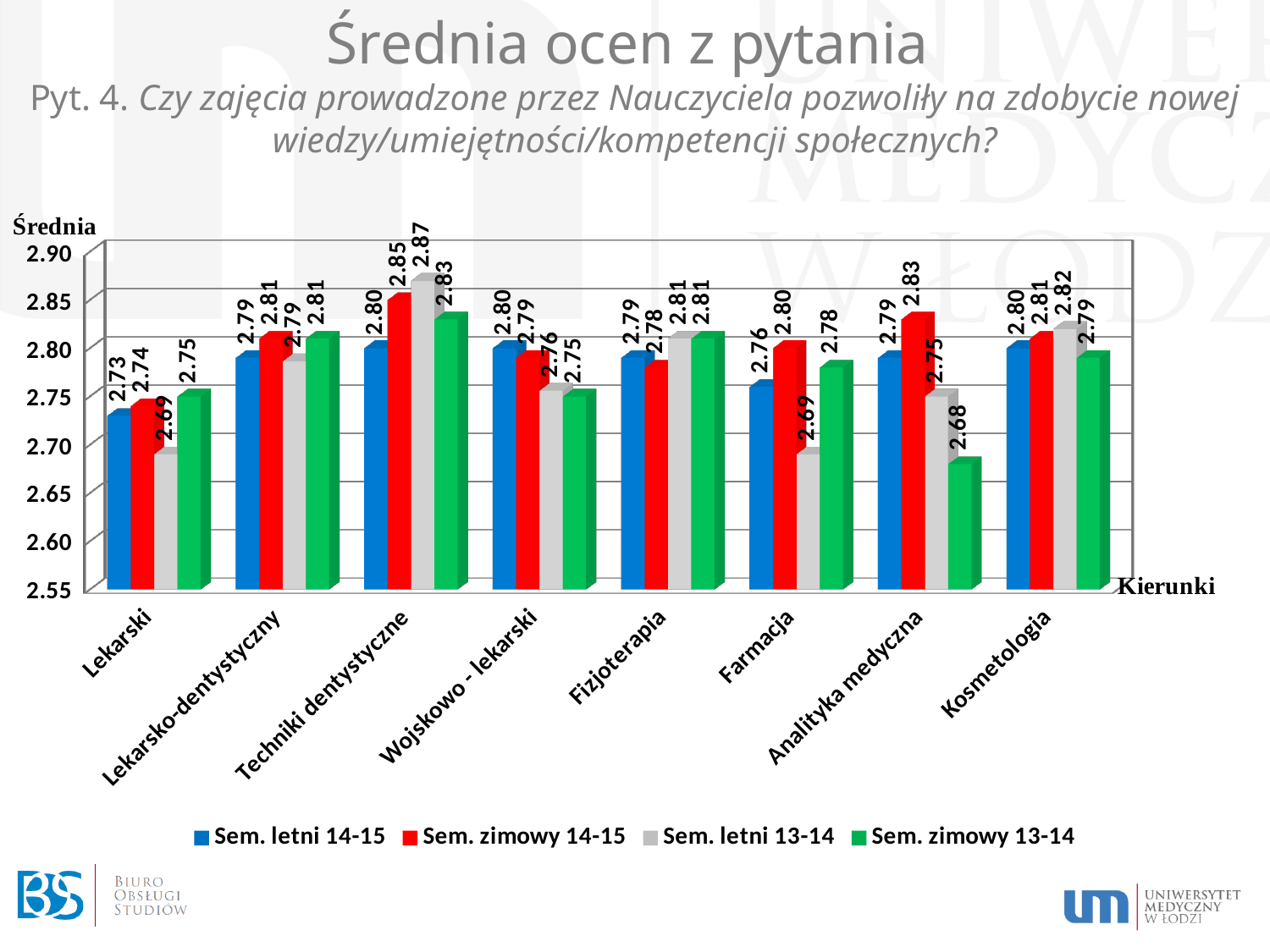
What is the value for Lekarski in the Sem. letni 14-15 series? 2.73 What is the value for Farmacja in the Sem. zimowy 14-15 series? 2.80 How many categories (kierunki) are shown on the x axis? 8 Which category has the lowest value in the Sem. letni 14-15 series? Lekarski Which colour represents the Sem. letni 13-14 series in the legend? Grey What is the value for Techniki dentystyczne in the Sem. letni 13-14 series? 2.87 What kind of chart is shown on the slide? Bar chart What is the value for Analityka medyczna in the Sem. zimowy 13-14 series? 2.68 How many series does the legend list? 4 Which is larger for Farmacja: the Sem. zimowy 14-15 value or the Sem. letni 13-14 value? Sem. zimowy 14-15 Which category has the highest value in the Sem. zimowy 14-15 series? Techniki dentystyczne What is the difference between the Sem. letni 13-14 value and the Sem. zimowy 13-14 value for Analityka medyczna? 0.07